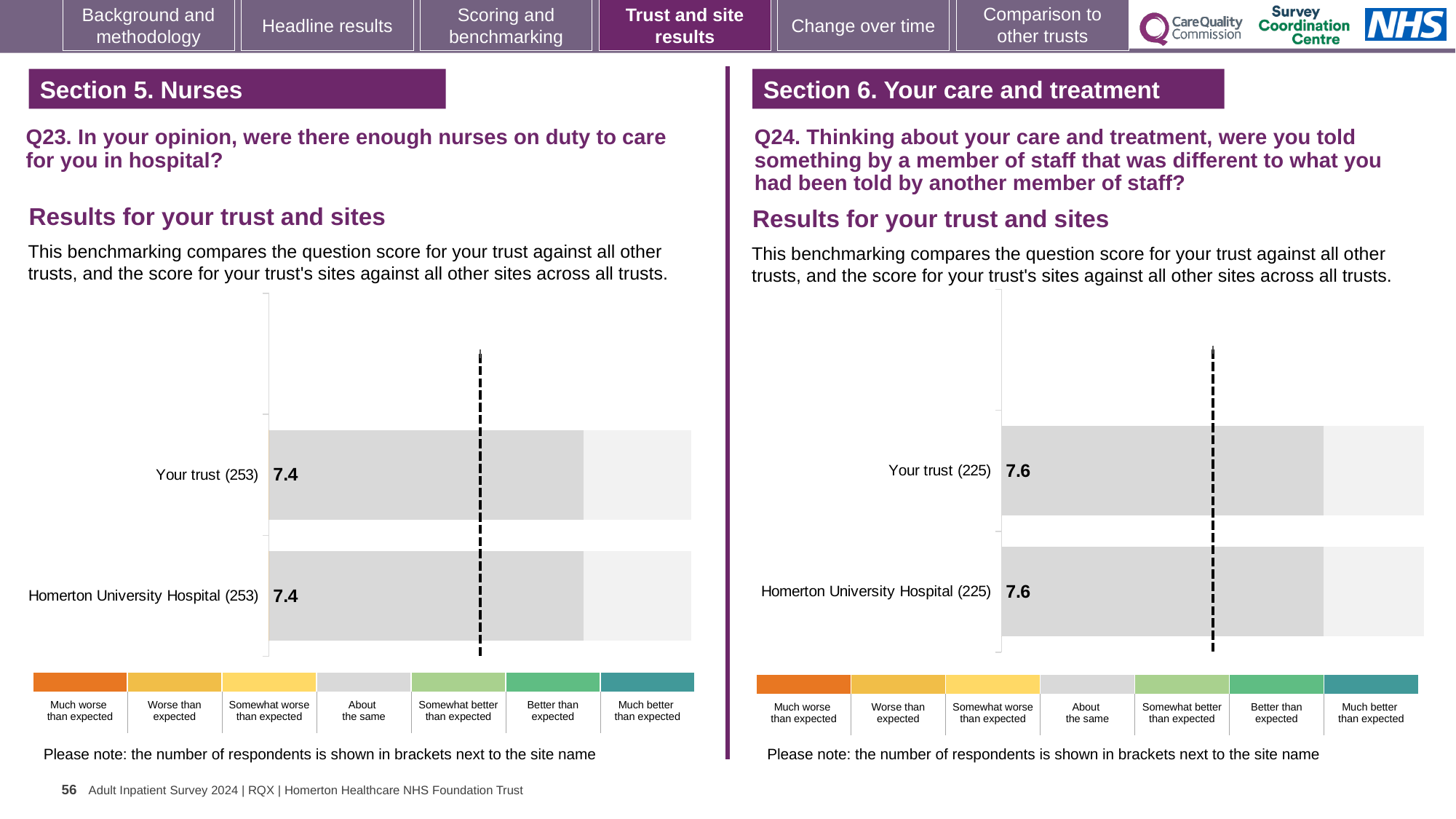
On the Q24 chart (right), what is the difference between the score for Your trust (225) and Homerton University Hospital (225)? 0 On the Q24 chart (right), what is the score for Homerton University Hospital (225)? 7.6 On the Q23 chart (left), what is the score for Your trust (253)? 7.4 On the Q23 chart (left), how many bars are plotted? 2 On the Q23 chart (left), what is the score for Homerton University Hospital (253)? 7.4 Is the score for Your trust on the Q24 chart (right) larger or smaller than the score for Your trust on the Q23 chart (left)? Larger How many respondents are shown in brackets for Your trust on the Q24 chart (right)? 225 On the Q23 chart (left), what is the difference between the score for Your trust (253) and Homerton University Hospital (253)? 0 How many respondents are shown in brackets for Your trust on the Q23 chart (left)? 253 What kind of chart is the Q23 chart on the left? Bar chart On the Q24 chart (right), how many bars are plotted? 2 On the Q24 chart (right), what is the score for Your trust (225)? 7.6